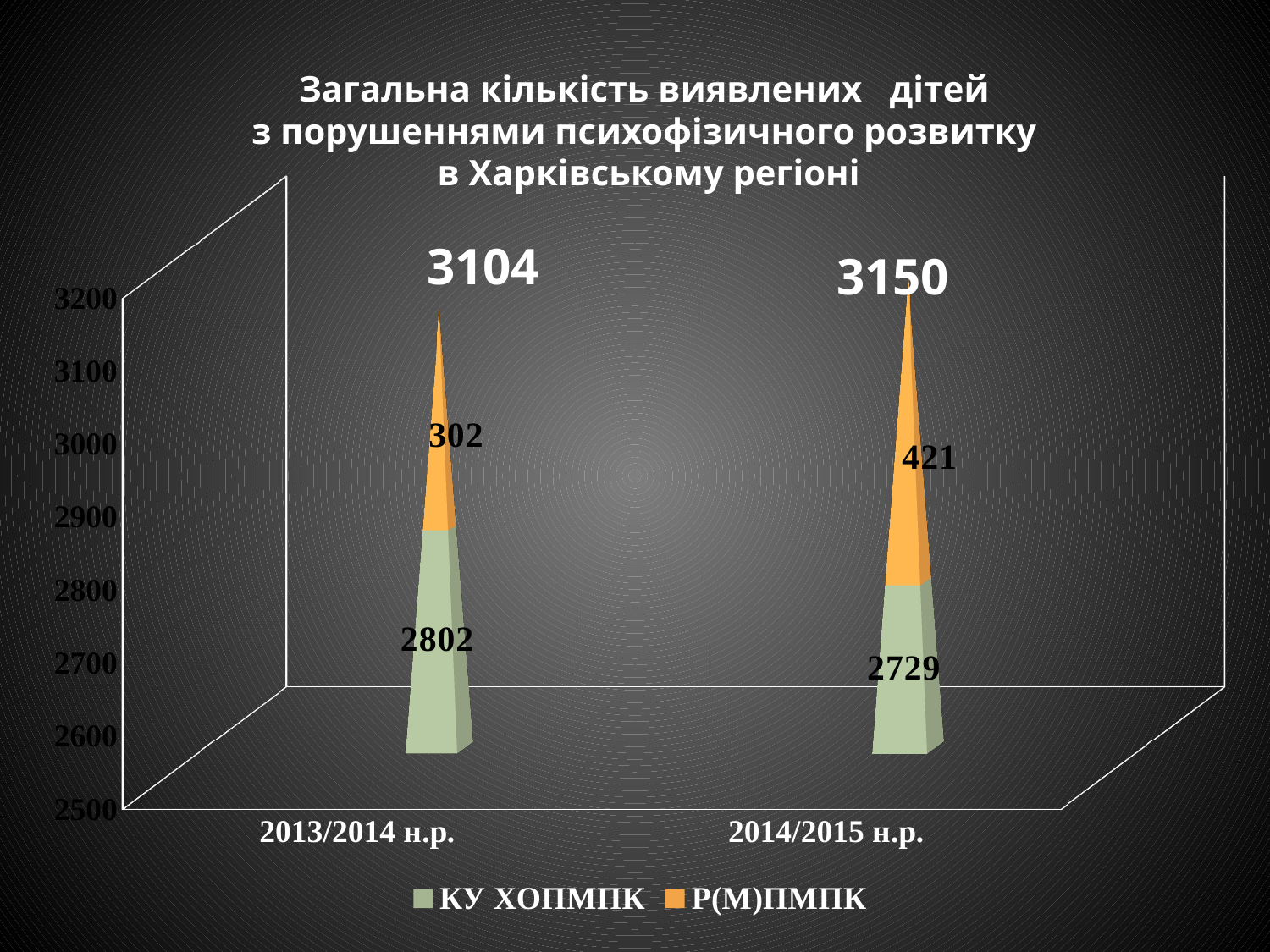
What is the difference between the КУ ХОПМПК values for 2013/2014 н.р. and 2014/2015 н.р.? 73 Which year has the higher value for Р(М)ПМПК, 2013/2014 н.р. or 2014/2015 н.р.? 2014/2015 н.р. What is the value for Р(М)ПМПК in 2014/2015 н.р.? 421 What is the value for КУ ХОПМПК in 2014/2015 н.р.? 2729 How many categories are shown on the x axis? 2 What is the difference between the Р(М)ПМПК values for 2014/2015 н.р. and 2013/2014 н.р.? 119 What is the total shown for the 2013/2014 н.р. bar? 3104 What is the value for КУ ХОПМПК in 2013/2014 н.р.? 2802 Which series is shown in orange in the legend? Р(М)ПМПК How many series does the legend list? 2 What is the total shown for the 2014/2015 н.р. bar? 3150 What is the value for Р(М)ПМПК in 2013/2014 н.р.? 302